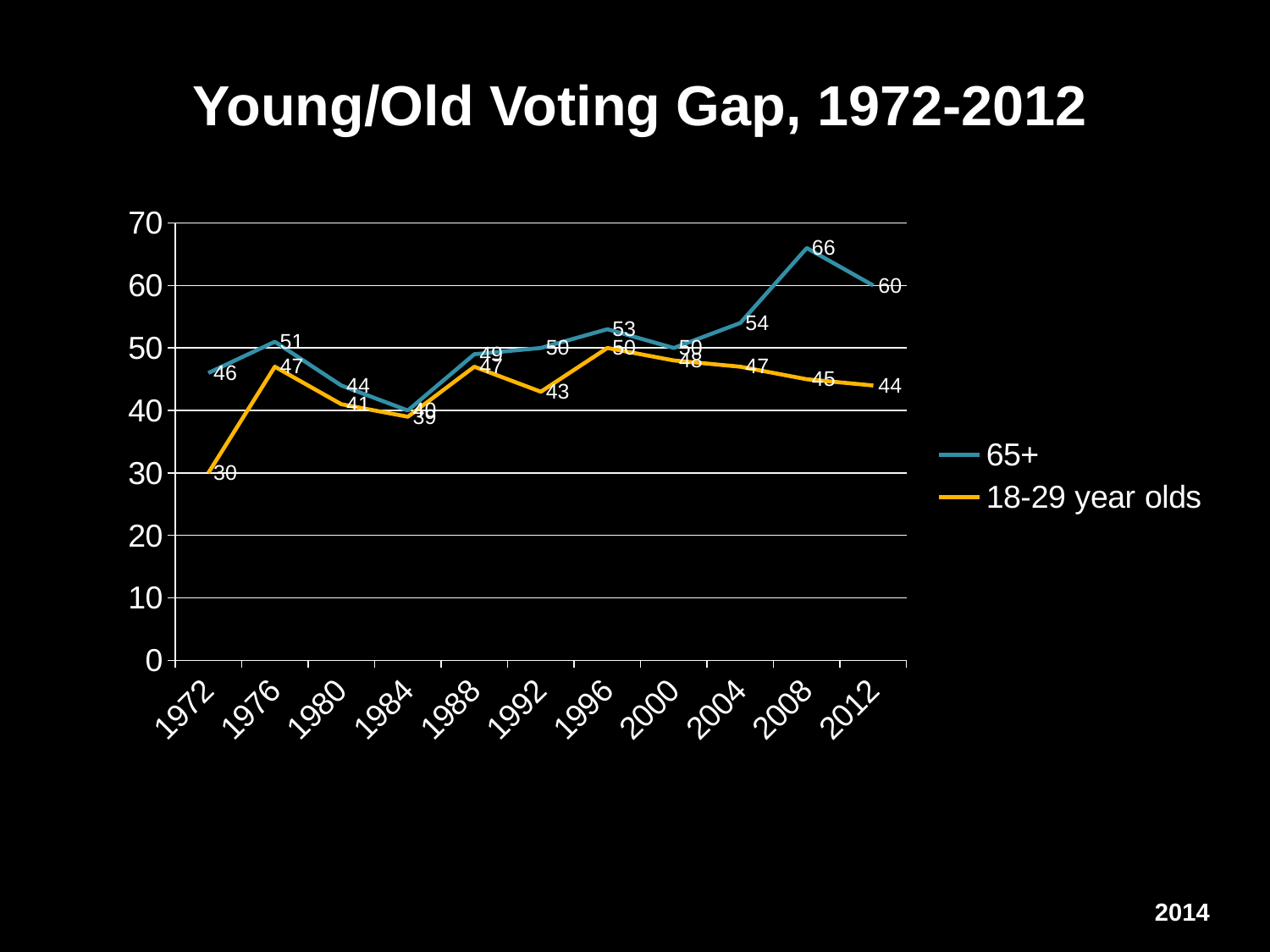
How many years are plotted along the x axis? 11 What kind of chart is shown on the slide? line chart What is the value for 18-29 year olds in 1972? 30 From 1996 to 2012, do the values for 18-29 year olds rise or fall? fall In which year does the 65+ series reach its highest value? 2008 What is the value for 18-29 year olds in 1992? 43 In which year is the value for 18-29 year olds lowest? 1972 In 1996, which series has the larger value, 65+ or 18-29 year olds? 65+ Is the value for 18-29 year olds in 1972 greater or less than 40? less What is the difference between the 65+ value and the 18-29 year olds value in 2012? 16 What is the value for the 65+ series in 2008? 66 How many series does the legend list? 2